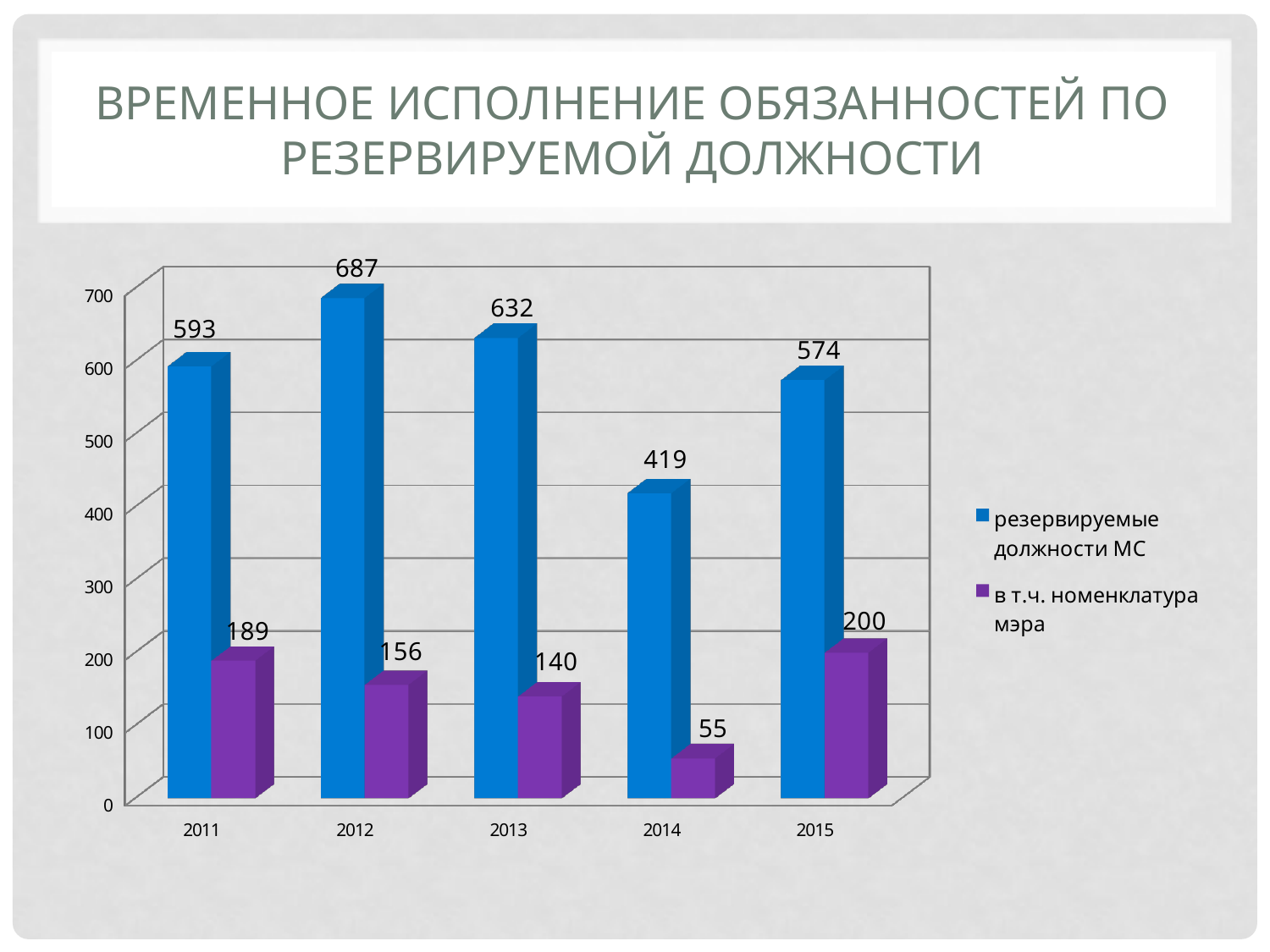
In which year is 'резервируемые должности МС' lowest? 2014 What is the value for 'резервируемые должности МС' in 2012? 687 What is the value for 'в т.ч. номенклатура мэра' in 2015? 200 In which year is 'резервируемые должности МС' highest? 2012 What is the value for 'в т.ч. номенклатура мэра' in 2014? 55 In which year is 'в т.ч. номенклатура мэра' lowest? 2014 How many years are shown on the x axis? 5 How many series does the legend list? 2 What is the difference between 'резервируемые должности МС' in 2012 and in 2014? 268 What kind of chart is shown on the slide? Bar chart Which is larger: 'резервируемые должности МС' in 2011 or in 2015? 2011 What is the difference between 'в т.ч. номенклатура мэра' in 2011 and in 2013? 49